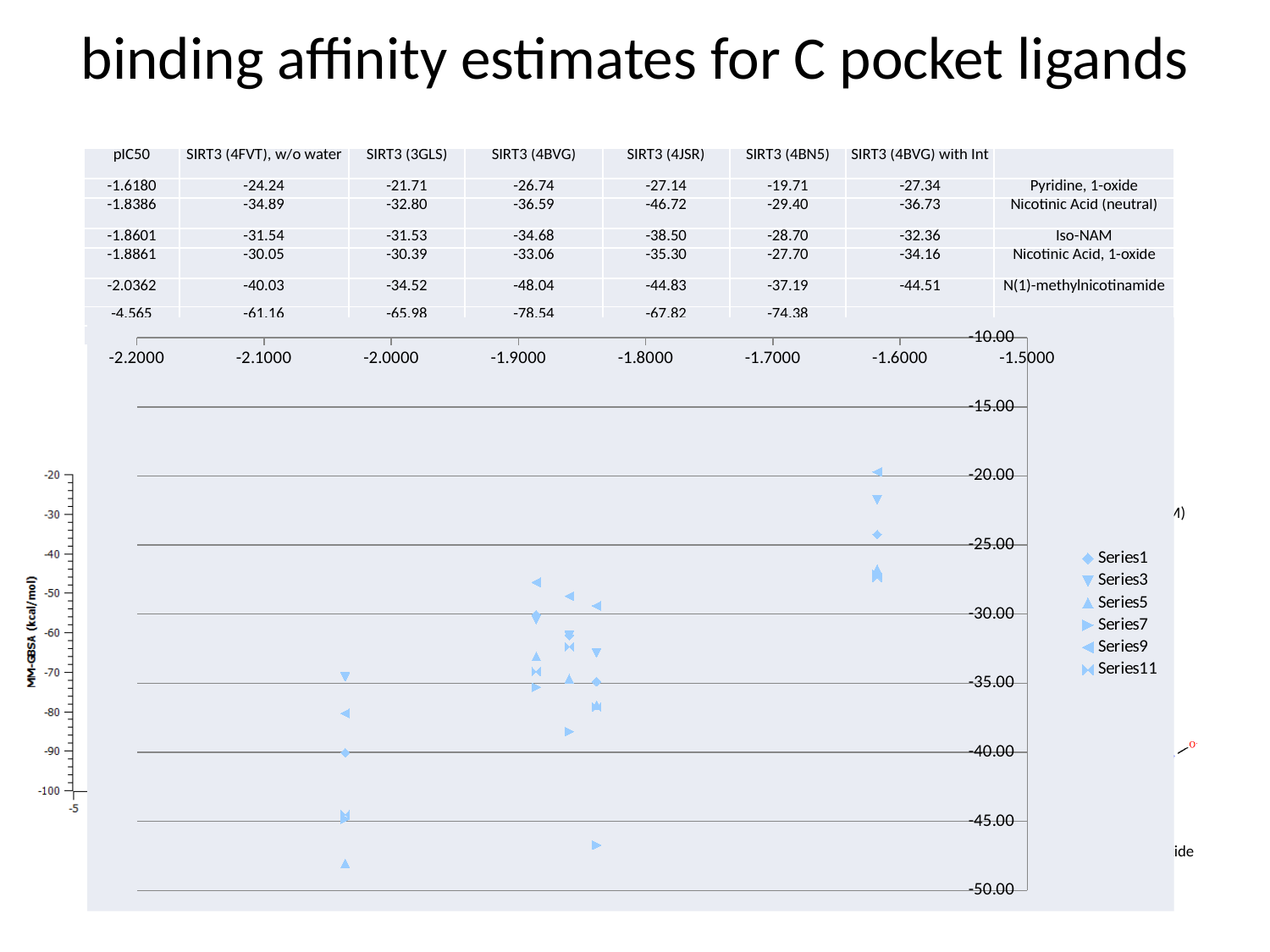
Is the Series7 point plotted near x = -1.84 greater or less than -45.00 on the y axis? less Which series has the highest plotted point on the chart? Series9 What kind of chart is shown on the slide? scatter chart Is the Series1 point plotted near x = -2.04 greater or less than -35.00 on the y axis? less Which series has the lowest plotted point on the chart? Series5 Is the Series5 point plotted near x = -2.04 greater or less than -45.00 on the y axis? less How many series does the chart legend list? 6 What is the last series name listed in the chart legend? Series11 What is the first series name listed in the chart legend? Series1 Is the Series9 point near x = -1.6 higher or lower than the Series3 point near x = -1.6? higher